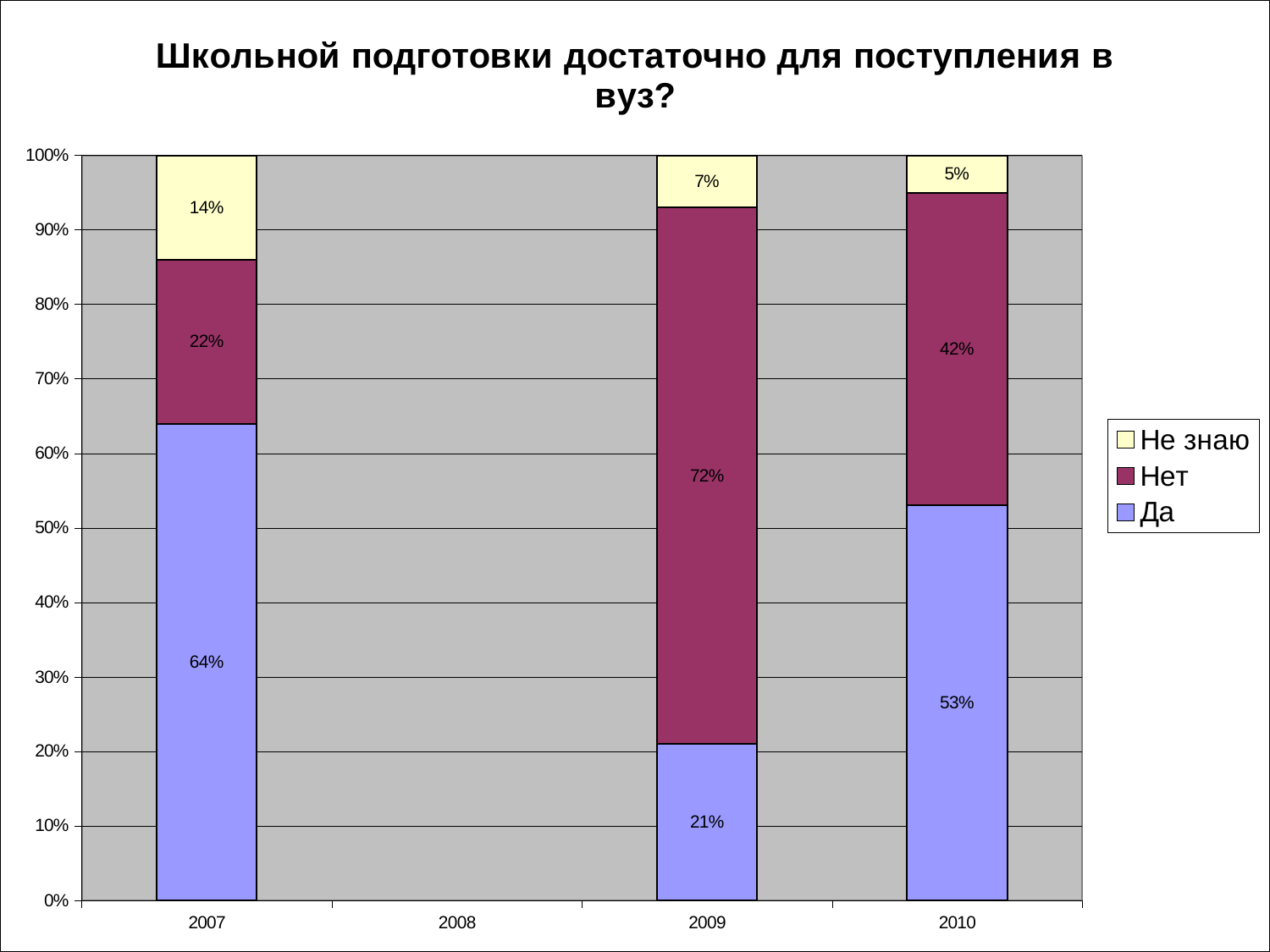
What is the value for "Да" in 2010? 53% How many series does the legend list? 3 What is the difference between the "Нет" values for 2009 and 2007? 50% What is the title of the chart? Школьной подготовки достаточно для поступления в вуз? In which year is the "Нет" share highest? 2009 What is the value for "Не знаю" in 2010? 5% What is the value for "Да" in 2007? 64% What is the value for "Нет" in 2009? 72% What kind of chart is shown on the slide? Stacked bar chart In which year is the "Да" share lowest? 2009 How many years are labelled on the x axis? 4 Which is larger in 2010, "Да" or "Нет"? Да